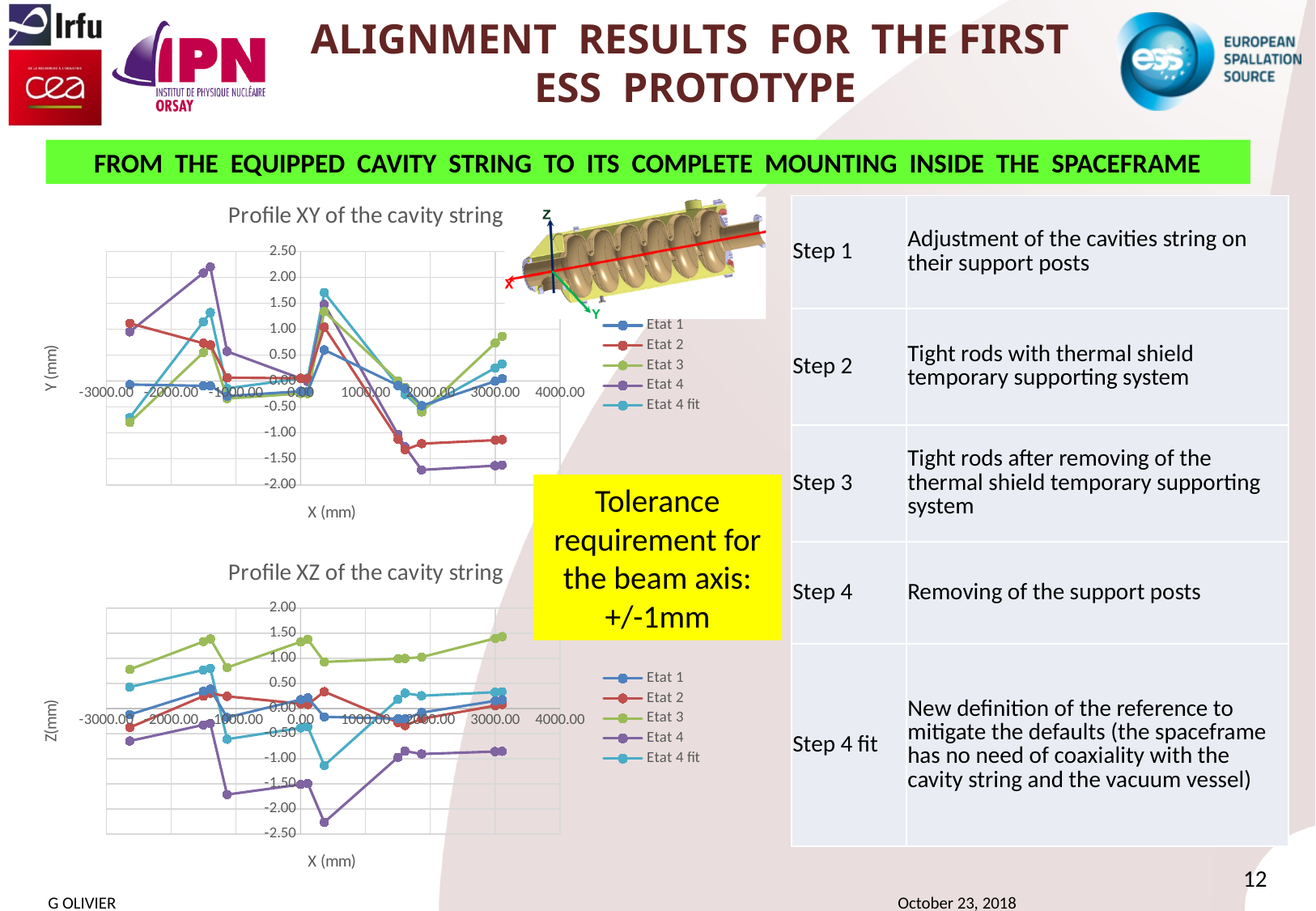
What is the title of the upper chart on the slide? Profile XY of the cavity string In the 'Profile XZ of the cavity string' chart, is the lowest value of the Etat 4 series greater or less than -2.00? less What kind of chart is the 'Profile XY of the cavity string' chart? line chart How many series does the legend of the 'Profile XY of the cavity string' chart list? 5 In the 'Profile XY of the cavity string' chart, which series reaches the highest value? Etat 4 How many series does the legend of the 'Profile XZ of the cavity string' chart list? 5 What kind of chart is the 'Profile XZ of the cavity string' chart? line chart What is the label of the vertical axis of the 'Profile XZ of the cavity string' chart? Z(mm) In the 'Profile XY of the cavity string' chart, is the lowest value of the Etat 4 series greater or less than -1.50? less In the 'Profile XY of the cavity string' chart, is the highest value of the Etat 4 series greater or less than 2.00? greater In the 'Profile XZ of the cavity string' chart, which series reaches the lowest value? Etat 4